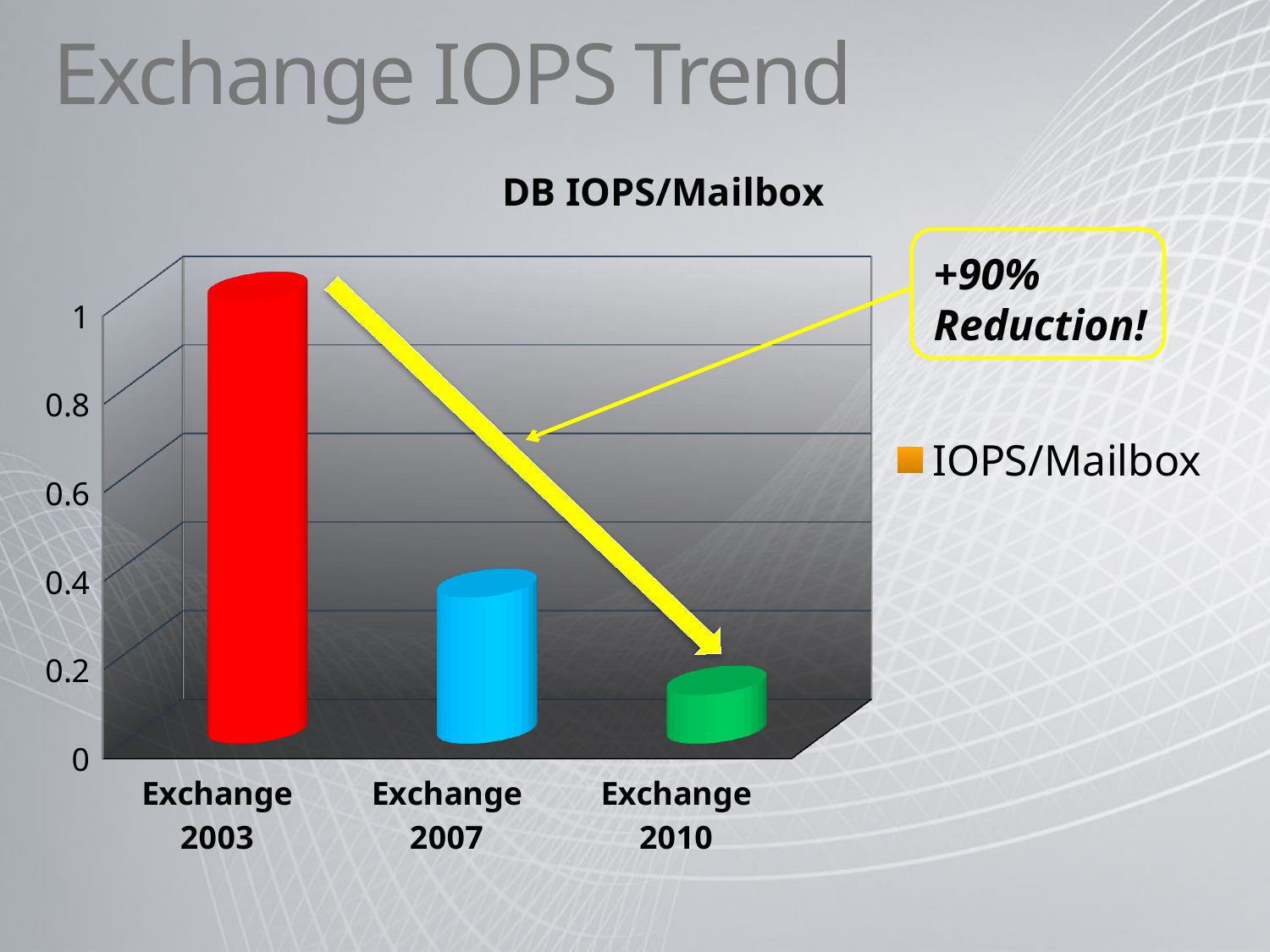
Is the value for Exchange 2010 greater or less than 0.4? less Which is larger, the value for Exchange 2007 or the value for Exchange 2010? Exchange 2007 Which category has the highest DB IOPS/Mailbox value? Exchange 2003 How many series does the chart's legend list? 1 What kind of chart is shown on the slide? bar chart Is the value for Exchange 2003 greater or less than 0.8? greater Do the values rise or fall from Exchange 2003 to Exchange 2010? fall Is the value for Exchange 2007 greater or less than 0.6? less Which category has the lowest DB IOPS/Mailbox value? Exchange 2010 How many categories are shown on the x axis of the chart? 3 What does the callout next to the chart say? +90% Reduction! What is the title of the chart? DB IOPS/Mailbox